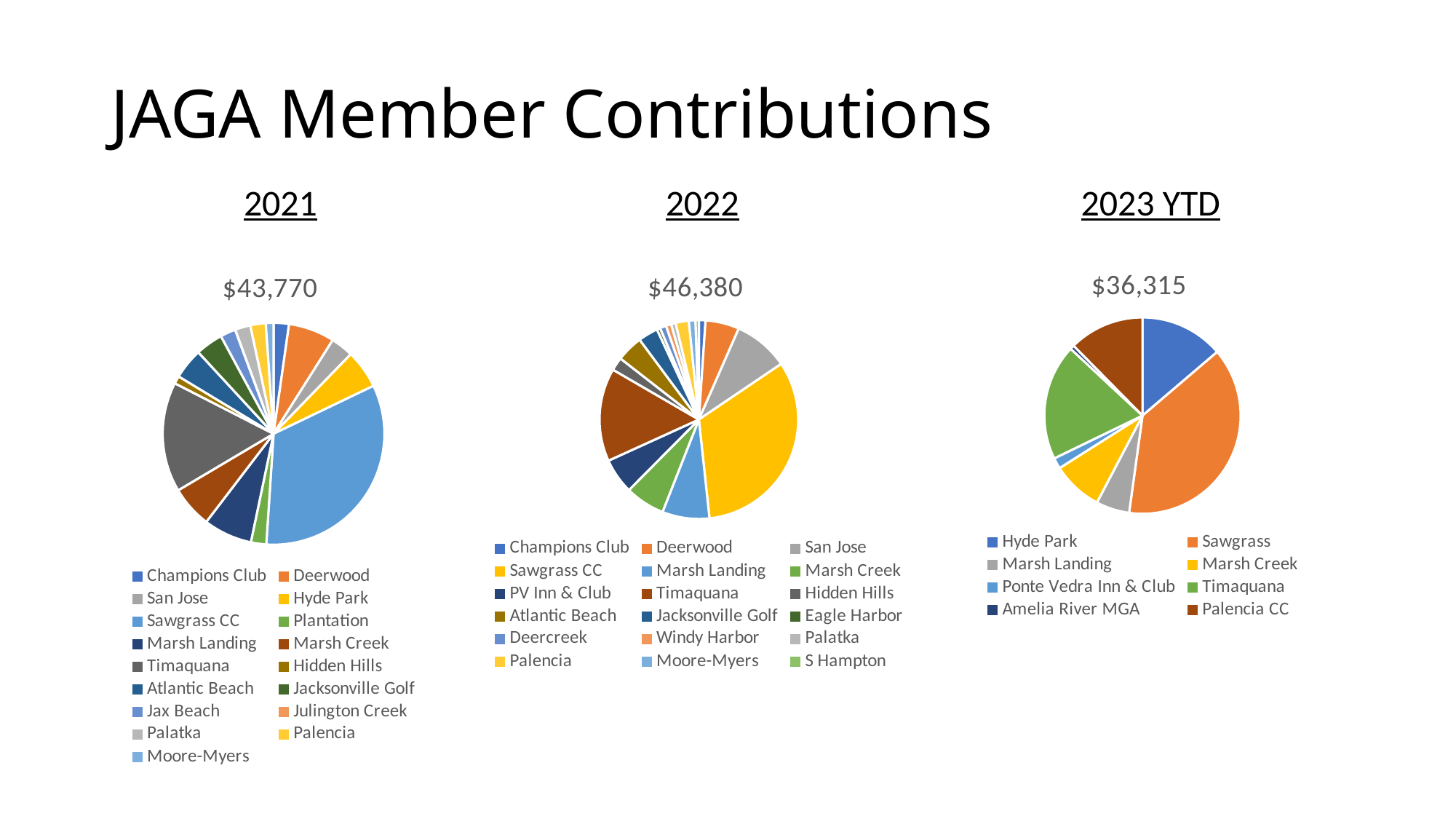
In the 2023 YTD pie chart, which is larger: Sawgrass or Hyde Park? Sawgrass What kind of chart is used for the 2021 contributions? Pie chart In the 2022 pie chart, which is larger: Sawgrass CC or Timaquana? Sawgrass CC What total is shown for the 2021 pie chart? $43,770 Which year's pie chart shows the highest total contributions? 2022 How many categories does the legend of the 2021 pie chart list? 17 What total is shown for the 2022 pie chart? $46,380 How many categories does the legend of the 2023 YTD pie chart list? 8 In the 2021 pie chart, which category has the largest slice? Sawgrass CC What total is shown for the 2023 YTD pie chart? $36,315 Which year's pie chart shows the lowest total contributions? 2023 YTD What is the difference between the 2022 total and the 2021 total? $2,610